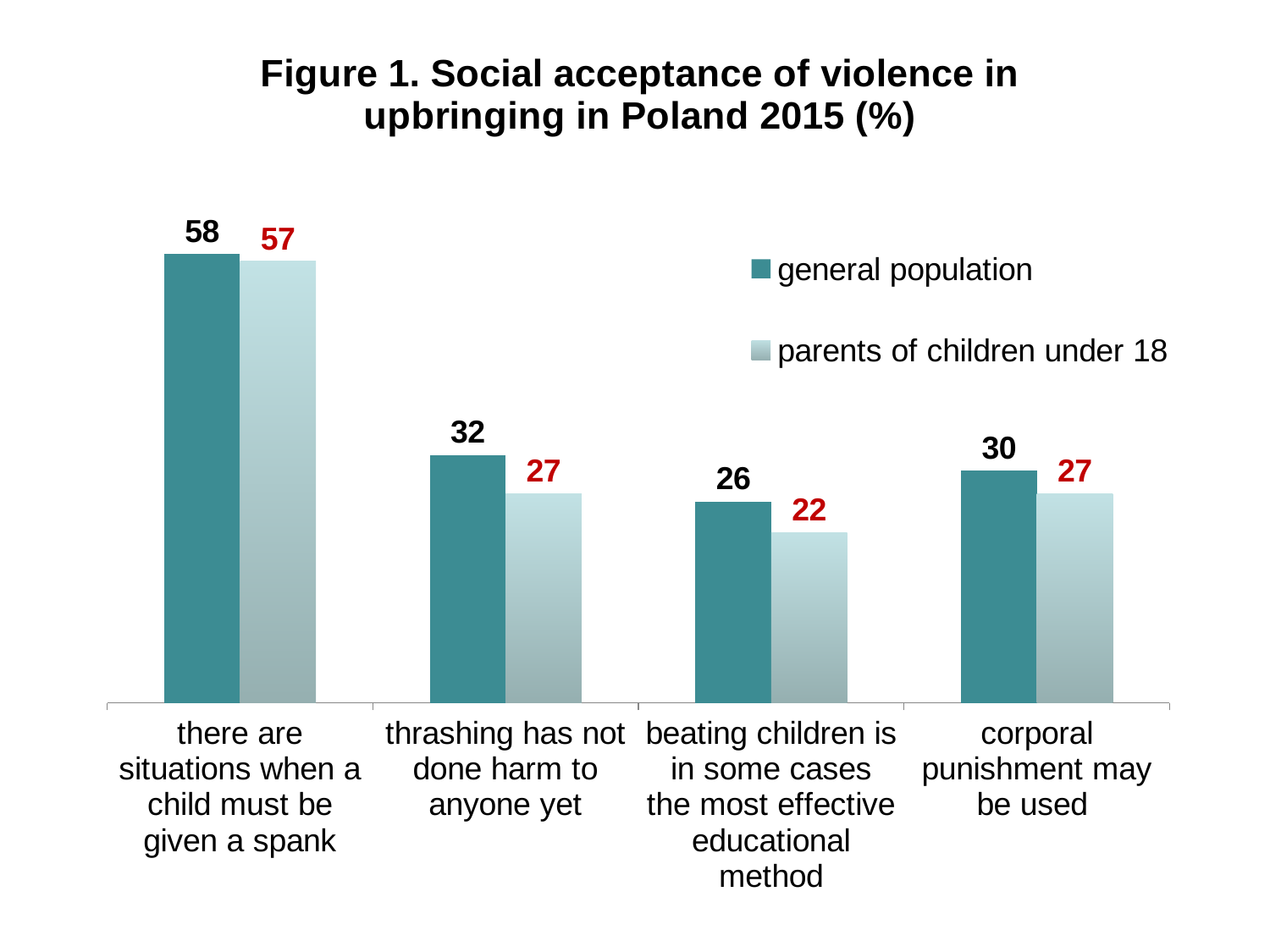
What is the value for 'general population' for 'there are situations when a child must be given a spank'? 58 What is the value for 'general population' for 'corporal punishment may be used'? 30 What is the difference between 'general population' and 'parents of children under 18' for 'thrashing has not done harm to anyone yet'? 5 Which is larger for 'corporal punishment may be used': 'general population' or 'parents of children under 18'? general population What is the difference between the 'general population' values for 'there are situations when a child must be given a spank' and 'thrashing has not done harm to anyone yet'? 26 Which category has the highest value for 'general population'? there are situations when a child must be given a spank What kind of chart is shown on the slide? bar chart How many categories are shown on the x axis? 4 Which category has the lowest value for 'parents of children under 18'? beating children is in some cases the most effective educational method How many series does the legend list? 2 What is the title of the chart? Figure 1. Social acceptance of violence in upbringing in Poland 2015 (%) What is the value for 'parents of children under 18' for 'beating children is in some cases the most effective educational method'? 22